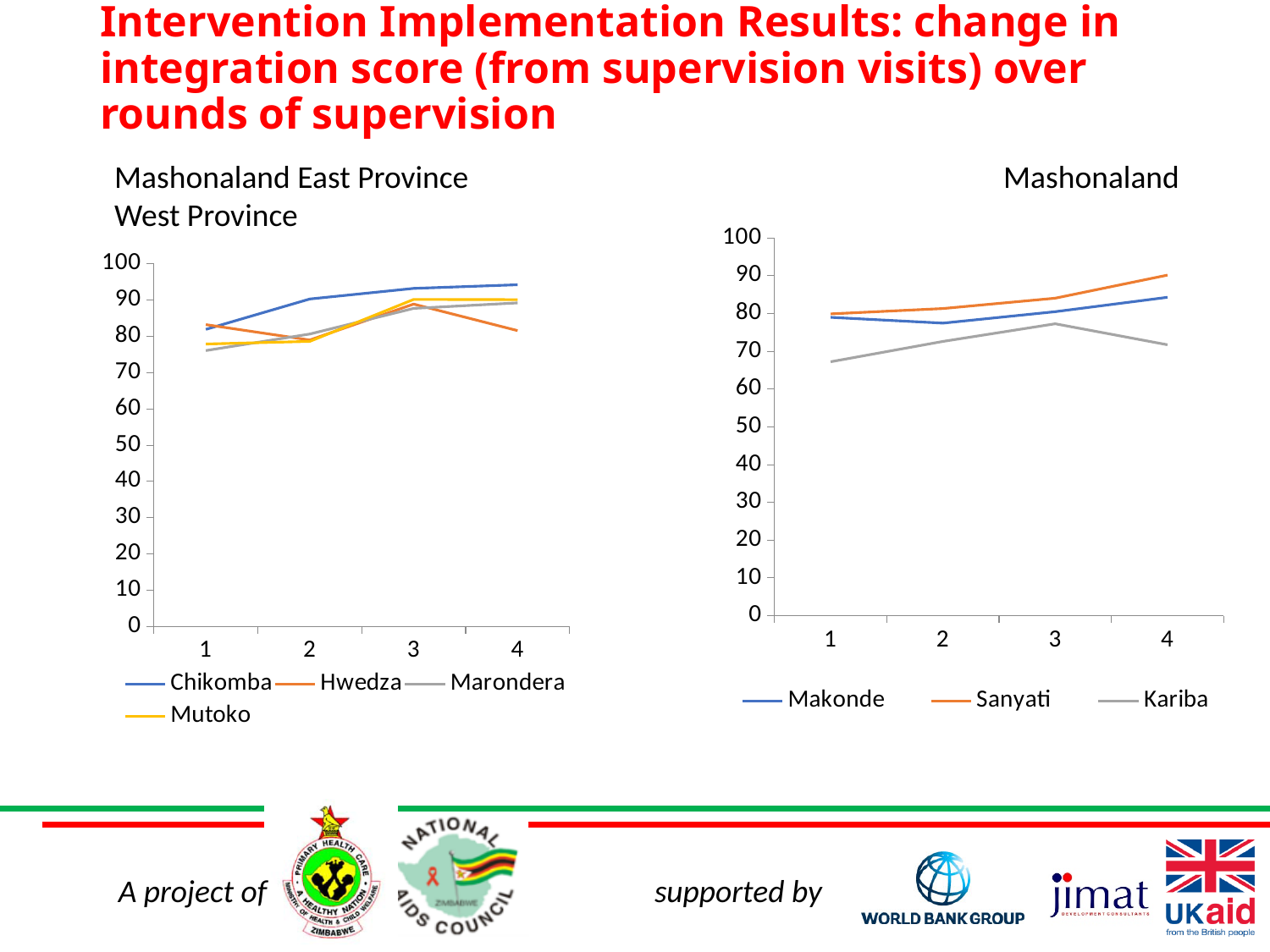
In the Mashonaland West Province chart on the right, does the Sanyati line rise or fall from round 1 to round 4? Rise In the Mashonaland East Province chart on the left, is the value for Marondera at round 1 greater or less than 80? less In the Mashonaland West Province chart on the right, is the value for Kariba at round 1 greater or less than 70? less In the Mashonaland West Province chart on the right, which district has the highest value at round 4? Sanyati In the Mashonaland East Province chart on the left, is the value for Chikomba at round 2 greater or less than 80? greater In the Mashonaland East Province chart on the left, which district has the highest value at round 4? Chikomba How many series does the legend of the Mashonaland West Province chart on the right list? 3 How many rounds of supervision are shown on the x axis of the Mashonaland West Province chart on the right? 4 In the Mashonaland East Province chart on the left, which district has the lowest value at round 4? Hwedza What type of chart is the Mashonaland East Province chart on the left? Line chart In the Mashonaland West Province chart on the right, which district has the lowest value at round 1? Kariba How many series does the legend of the Mashonaland East Province chart on the left list? 4